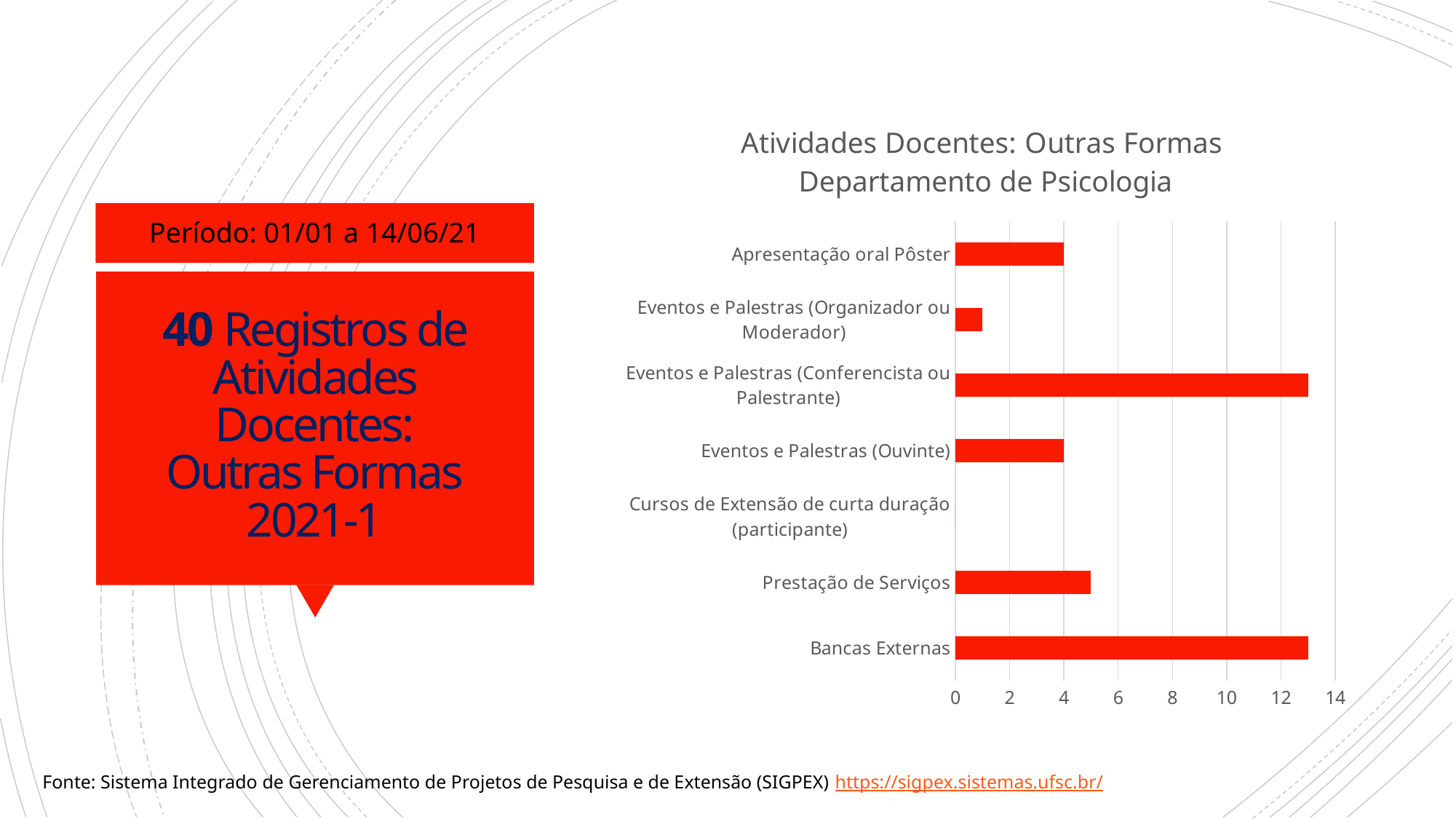
Is the value for Prestação de Serviços greater or less than 4? greater Which category has the lowest value? Cursos de Extensão de curta duração (participante) Is the value for Eventos e Palestras (Organizador ou Moderador) greater or less than 2? less What is the title of the chart? Atividades Docentes: Outras Formas Departamento de Psicologia What colour are the bars in the chart? red What is the value for Eventos e Palestras (Ouvinte)? 4 Which is larger, the value for Bancas Externas or the value for Prestação de Serviços? Bancas Externas What is the value for Apresentação oral Pôster? 4 Is the value for Eventos e Palestras (Conferencista ou Palestrante) greater or less than 12? greater How many categories are plotted in the chart? 7 What kind of chart is shown on the slide? bar chart What is the value for Cursos de Extensão de curta duração (participante)? 0